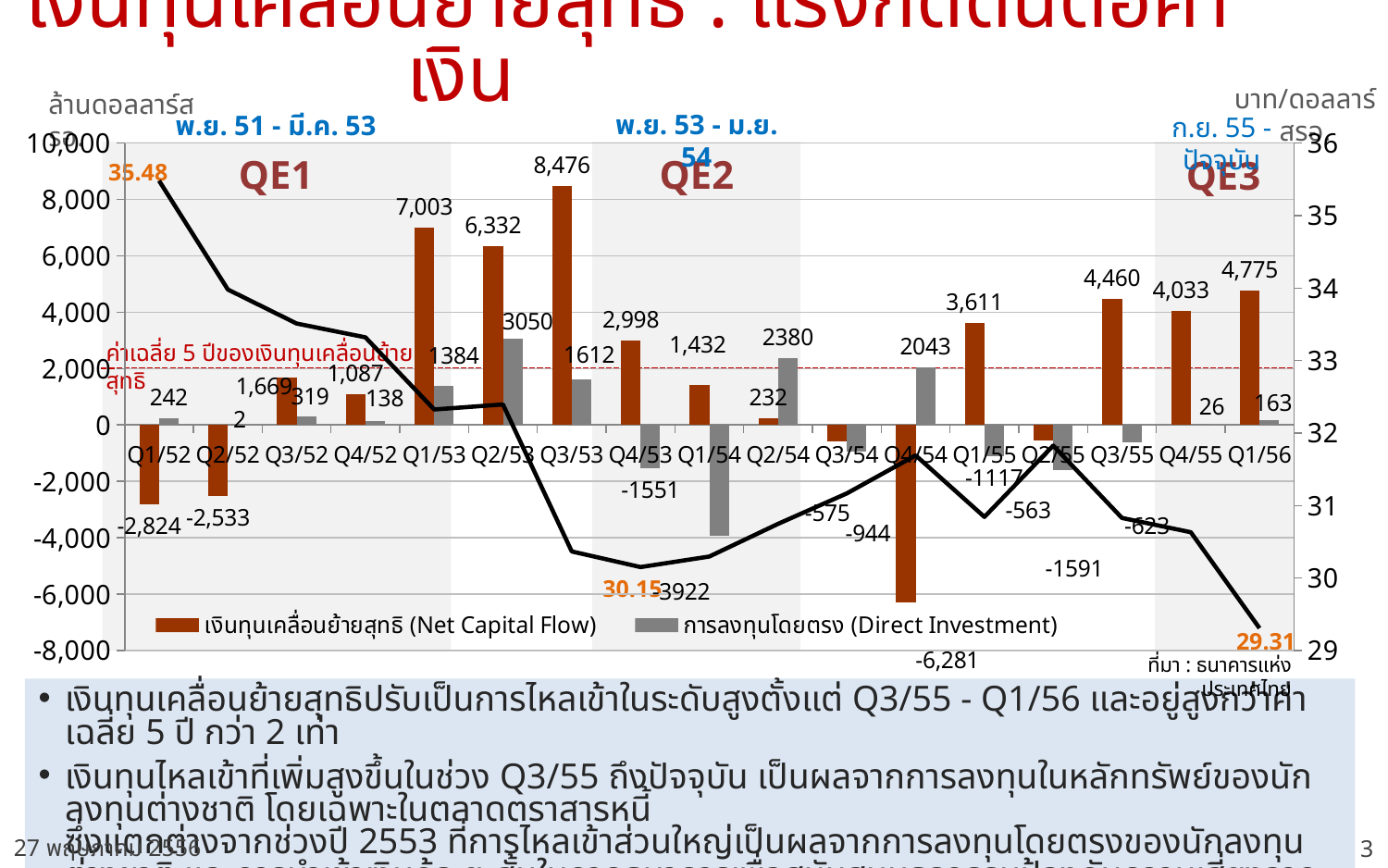
Which is larger, the Net Capital Flow in Q1/53 or in Q2/53? Q1/53 What is the Direct Investment value for Q2/53? 3050 What kind of chart is used for the Net Capital Flow and Direct Investment series? Bar chart What is the difference between the Net Capital Flow in Q1/56 and Q4/55? 742 Which quarter has the lowest Direct Investment value? Q1/54 What is the Net Capital Flow value for Q3/53? 8,476 What is the exchange rate value labelled at the end of the line in Q1/56? 29.31 Which quarter has the highest Net Capital Flow? Q3/53 What is the Net Capital Flow value for Q4/54? -6,281 How many quarters are shown on the x axis? 17 How many series does the legend list? 2 Which quarter has the lowest Net Capital Flow? Q4/54